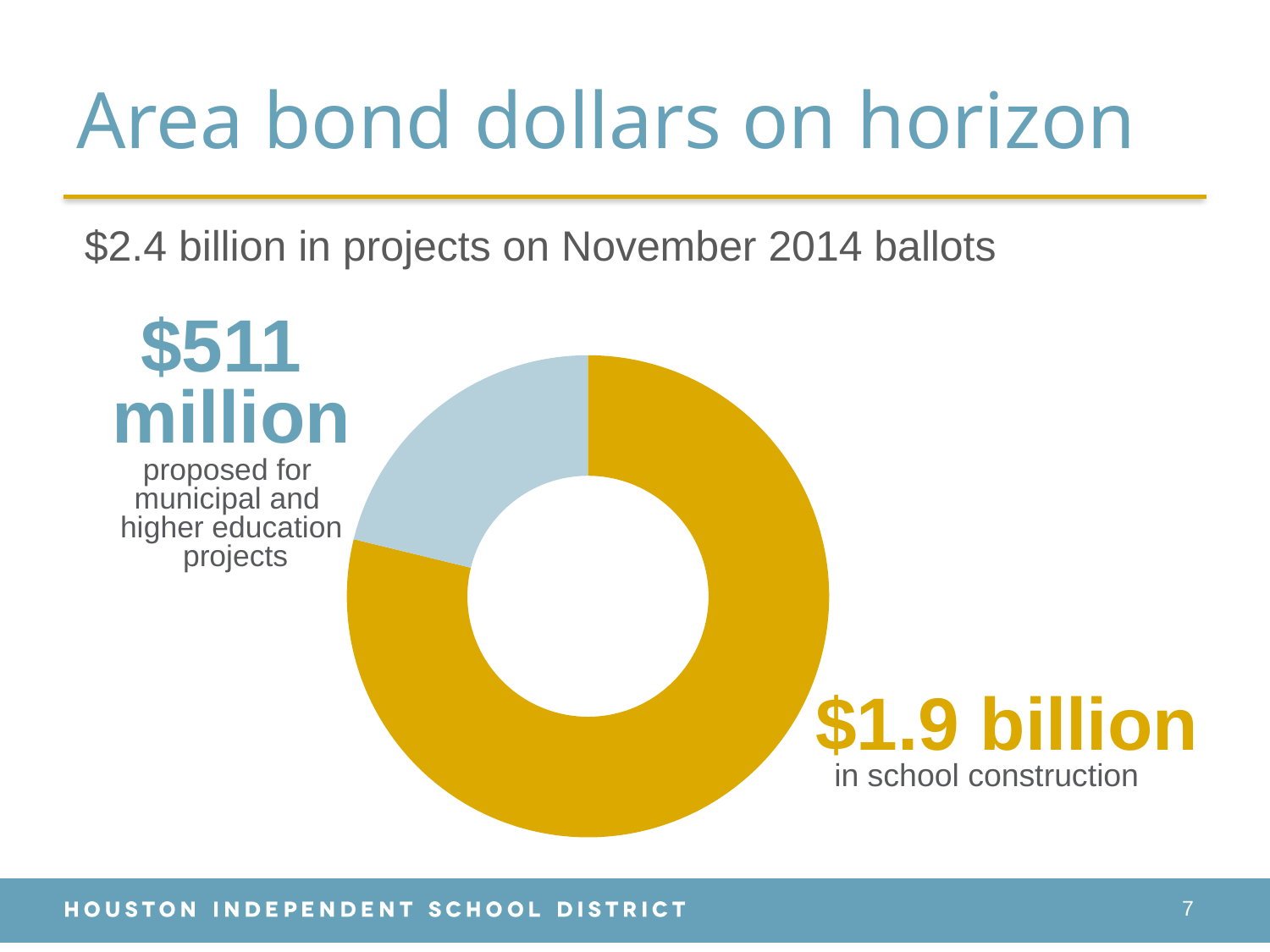
What colour is the school construction segment of the chart? gold How much is proposed for municipal and higher education projects in the chart? $511 million Which is larger: the amount for school construction or the amount for municipal and higher education projects? school construction Which segment of the chart is the largest? school construction How many segments does the chart have? 2 Which segment of the chart is the smallest? municipal and higher education projects What kind of chart is shown on the slide? donut chart How much is allocated to school construction in the chart? $1.9 billion According to the slide, what is the total value of projects on November 2014 ballots? $2.4 billion What colour is the municipal and higher education projects segment of the chart? light blue